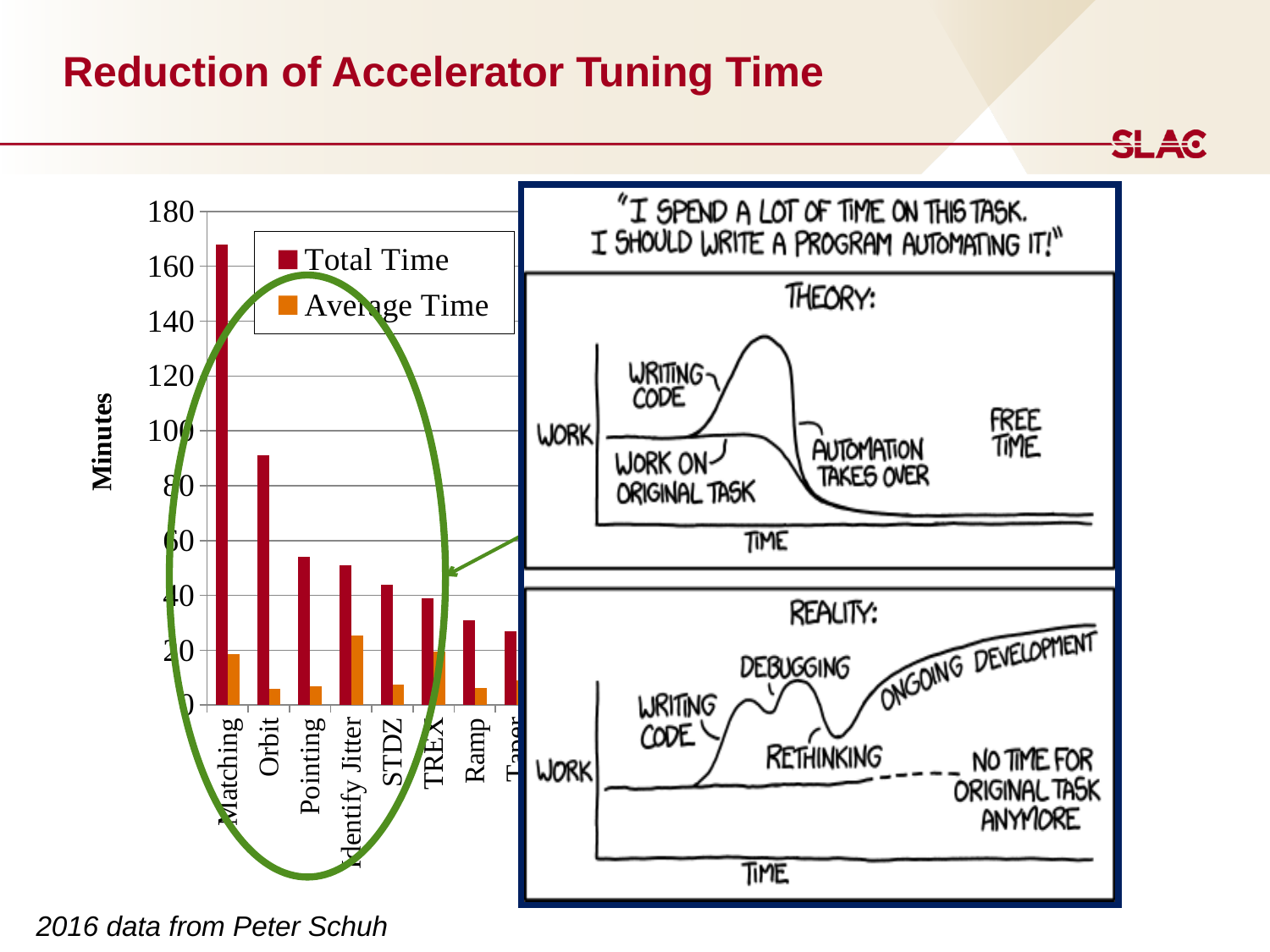
Which is larger, the Average Time for Identify Jitter or the Average Time for Orbit? Identify Jitter What kind of chart is shown on the left of the slide? bar chart Does the Total Time generally rise or fall moving from Matching to Ramp along the x axis? fall Is the Total Time for Matching greater or less than 140 minutes? greater Is the Total Time for Pointing greater or less than 60 minutes? less What is the label on the vertical axis of the bar chart? Minutes What are the two series named in the legend of the bar chart? Total Time and Average Time Is the Total Time for Orbit greater or less than 80 minutes? greater Which category has the highest Total Time in the bar chart? Matching How many series does the legend of the bar chart list? 2 Which is larger, the Total Time for Orbit or the Total Time for Pointing? Orbit